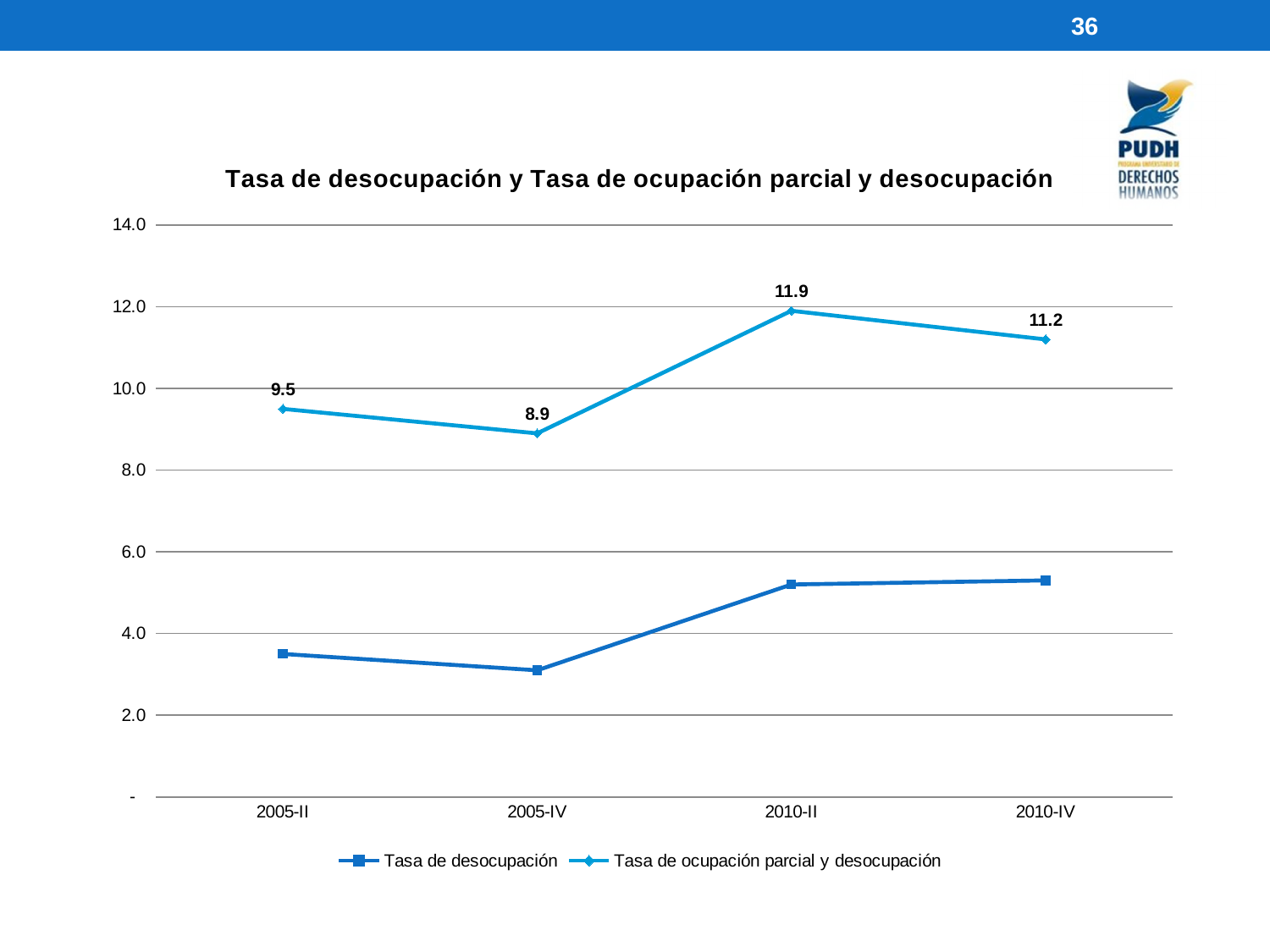
How many series does the legend list? 2 In which period is Tasa de ocupación parcial y desocupación lowest? 2005-IV Is the value of Tasa de desocupación for 2005-IV greater or less than 4.0? less What is the value of Tasa de ocupación parcial y desocupación for 2010-IV? 11.2 Which is larger for Tasa de ocupación parcial y desocupación: 2005-II or 2010-IV? 2010-IV What kind of chart is shown on the slide? Line chart In which period is Tasa de ocupación parcial y desocupación highest? 2010-II Is the value of Tasa de desocupación for 2010-IV greater or less than 4.0? greater What is the value of Tasa de ocupación parcial y desocupación for 2010-II? 11.9 What is the difference between the Tasa de ocupación parcial y desocupación values for 2010-II and 2005-IV? 3.0 How many periods are shown on the x axis? 4 What is the value of Tasa de ocupación parcial y desocupación for 2005-II? 9.5